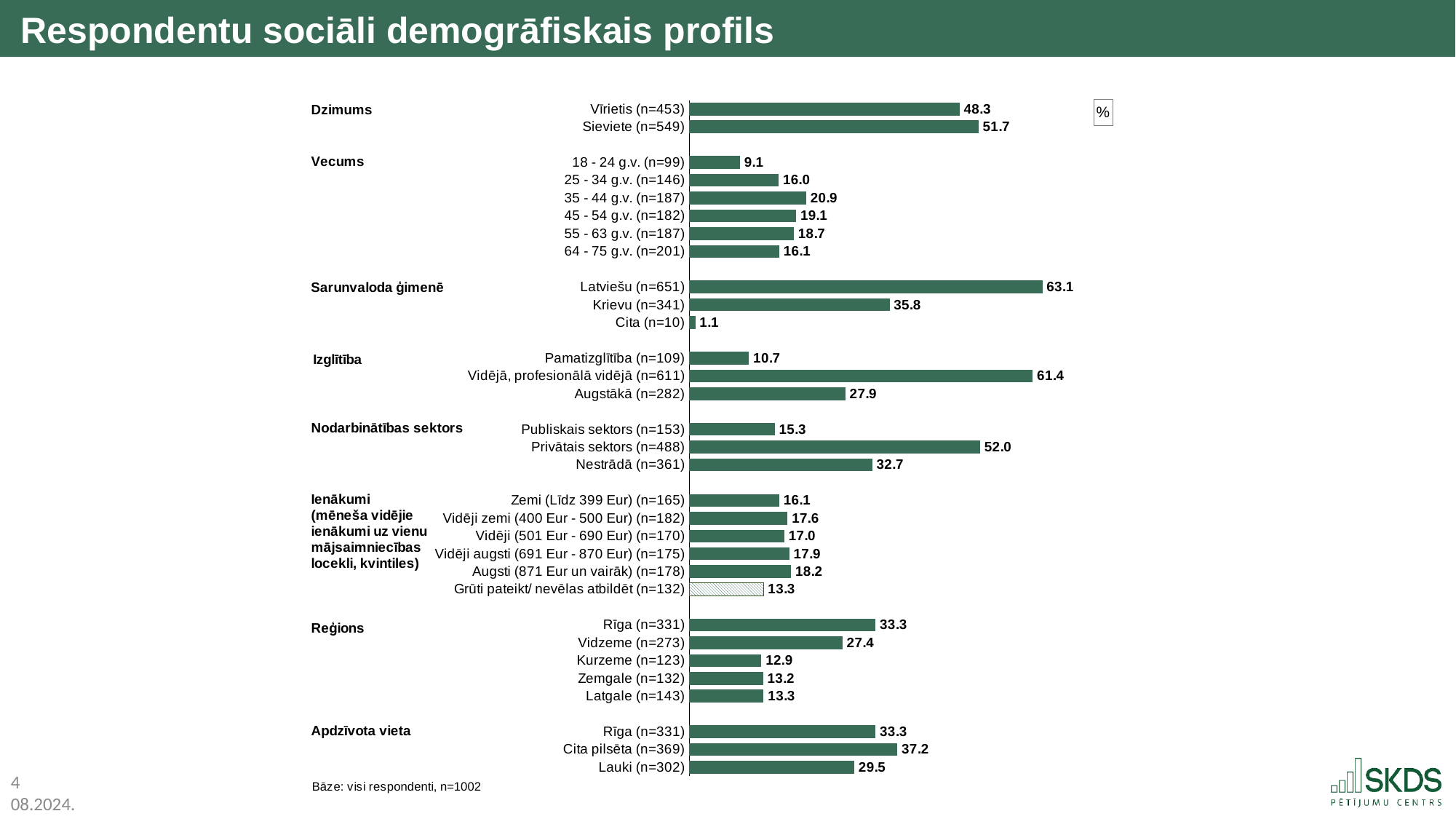
What is the title of the slide? Respondentu sociāli demogrāfiskais profils What is the value for Privātais sektors (n=488)? 52.0 Which age group (Vecums) has the highest value? 35 - 44 g.v. (n=187) What is the difference between the values for Latviešu (n=651) and Krievu (n=341)? 27.3 Which is larger, the value for Augstākā (n=282) or Pamatizglītība (n=109)? Augstākā (n=282) What kind of chart is shown on the slide? Bar chart What is the value for Latviešu (n=651)? 63.1 Which region (Reģions) has the lowest value? Kurzeme (n=123) What is the difference between the values for Vīrietis (n=453) and Sieviete (n=549)? 3.4 What is the value for Sieviete (n=549)? 51.7 Which is larger, the value for Cita pilsēta (n=369) or Lauki (n=302)? Cita pilsēta (n=369) What is the value for Grūti pateikt/ nevēlas atbildēt (n=132)? 13.3